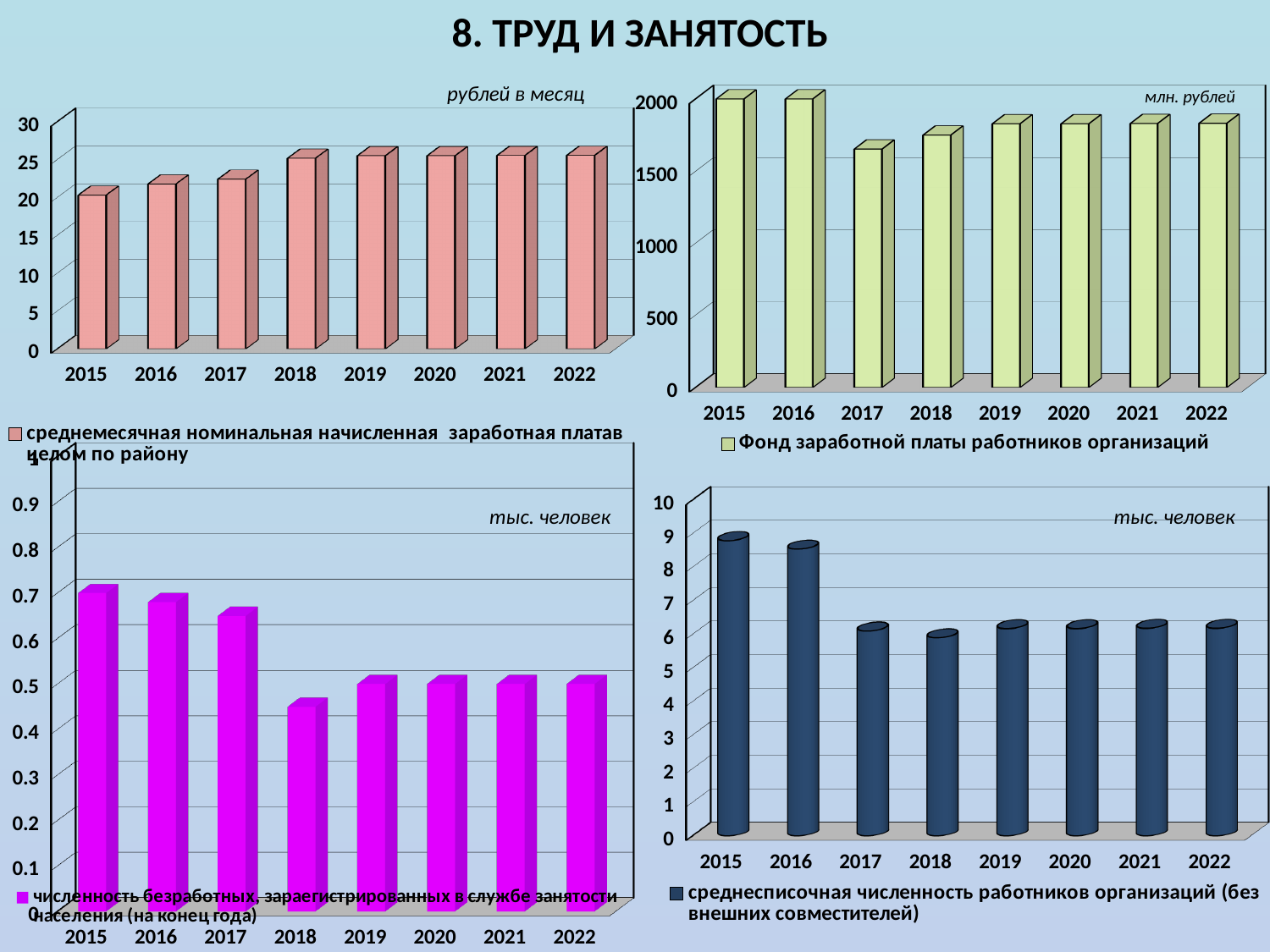
In the bottom-left chart (численность безработных), is the value for 2018 greater or less than 0.5? less In the bottom-left chart (численность безработных), which year has the lowest value? 2018 In the top-left chart (среднемесячная номинальная начисленная заработная плата), do the values generally rise or fall from 2015 to 2022? rise In the bottom-right chart (среднесписочная численность работников организаций), is the value for 2016 larger or smaller than the value for 2017? larger What kind of chart is the top-left chart (среднемесячная номинальная начисленная заработная плата)? bar chart In the bottom-right chart (среднесписочная численность работников организаций), which year has the highest value? 2015 How many years are shown on the x axis of the top-right chart (Фонд заработной платы работников организаций)? 8 In the top-left chart (среднемесячная номинальная начисленная заработная плата), is the value for 2015 greater or less than 25? less In the top-right chart (Фонд заработной платы работников организаций), is the value for 2017 greater or less than 2000? less In the top-right chart (Фонд заработной платы работников организаций), which year has the lowest value? 2017 In the top-left chart (среднемесячная номинальная начисленная заработная плата), which year has the lowest value? 2015 What unit is shown on the top-right chart (Фонд заработной платы работников организаций)? млн. рублей